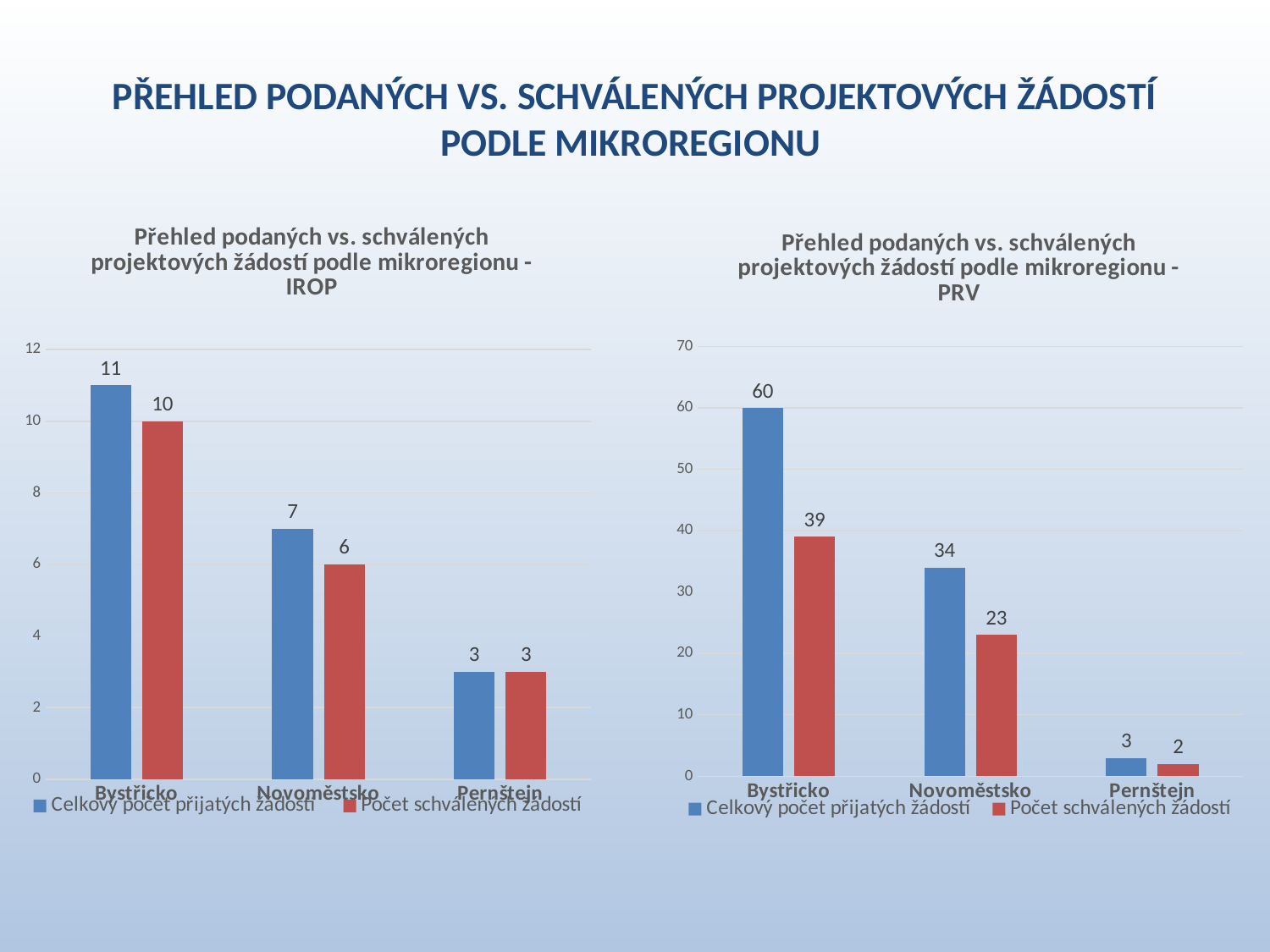
In the PRV chart (right), which microregion has the highest Celkový počet přijatých žádostí? Bystřicko In the IROP chart (left), what is the value of Celkový počet přijatých žádostí for Bystřicko? 11 In the IROP chart (left), which microregion has the lowest Počet schválených žádostí? Pernštejn In the PRV chart (right), what is the difference between Celkový počet přijatých žádostí and Počet schválených žádostí for Bystřicko? 21 How many series does the legend of the PRV chart (right) list? 2 What type of chart is the PRV chart (right)? Bar chart In the IROP chart (left), what is the difference between Celkový počet přijatých žádostí and Počet schválených žádostí for Novoměstsko? 1 In the PRV chart (right), which is larger: Počet schválených žádostí for Bystřicko or Celkový počet přijatých žádostí for Novoměstsko? Počet schválených žádostí for Bystřicko How many microregions are shown on the x axis of the IROP chart (left)? 3 In the PRV chart (right), what is the value of Počet schválených žádostí for Pernštejn? 2 In the PRV chart (right), what is the value of Celkový počet přijatých žádostí for Novoměstsko? 34 In the IROP chart (left), what is the value of Počet schválených žádostí for Novoměstsko? 6